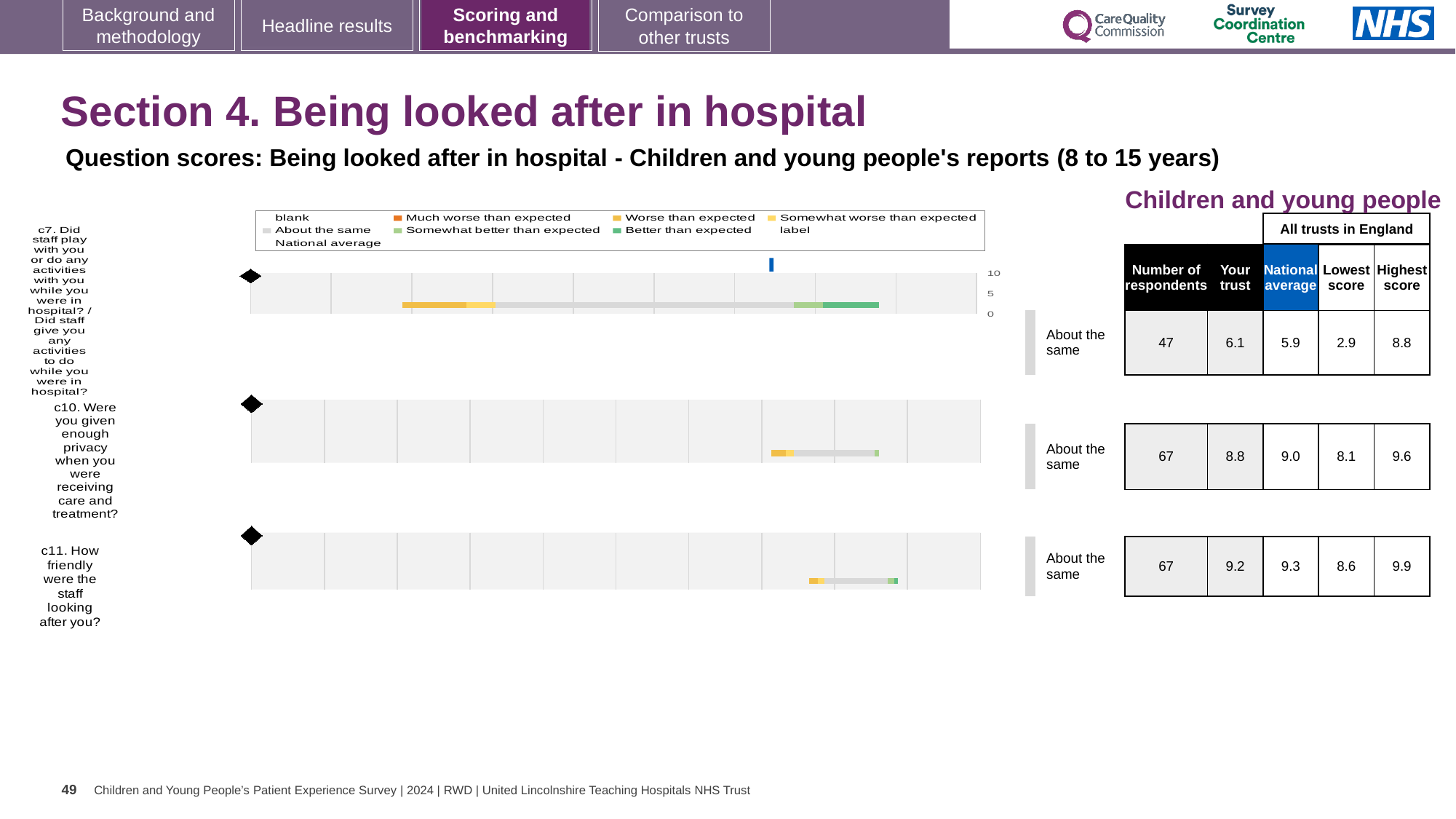
What benchmark category is shown for c11? About the same Which question has the highest 'Your trust' score? c11. How friendly were the staff looking after you? How many respondents answered c7? 47 What is the difference between the highest score and the lowest score for c7? 5.9 For c10, which is larger: the trust's score or the national average? National average What is the national average score for c10 (Were you given enough privacy when you were receiving care and treatment?)? 9.0 What is the trust's score for c7 (Did staff play with you or do any activities with you while you were in hospital?)? 6.1 How many questions are plotted in the chart? 3 Which question has the lowest 'Your trust' score? c7. Did staff play with you or do any activities with you while you were in hospital? What is the highest score across all trusts in England for c11 (How friendly were the staff looking after you?)? 9.9 What kind of chart is used to show the question scores on this slide? bar chart How many entries does the chart legend list? 9